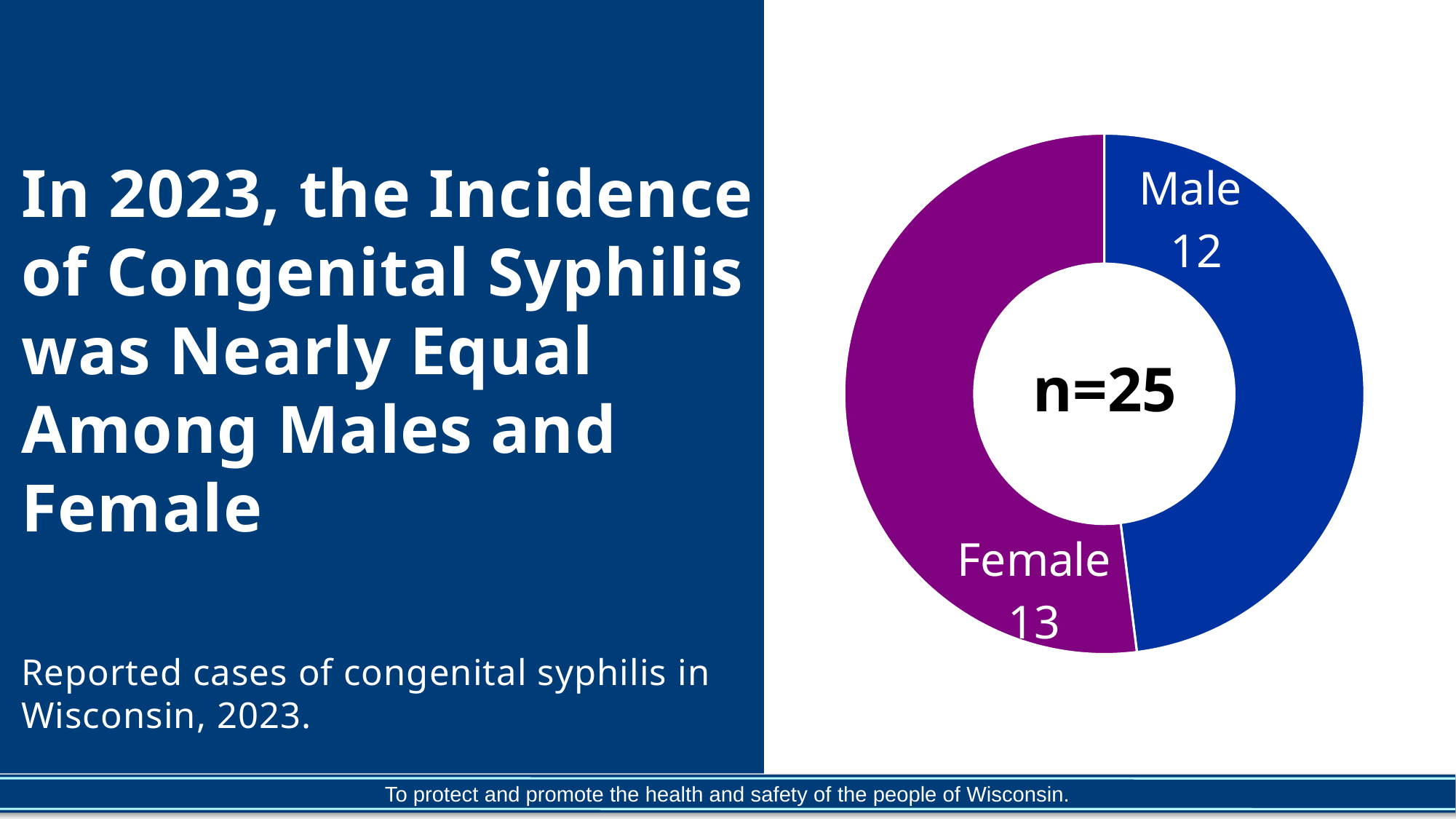
What is the number of reported congenital syphilis cases among females? 13 Which category has the smallest number of cases? Male Which category has the larger number of cases, Male or Female? Female What share of the total cases are female? 52% What is the difference between the number of female and male cases? 1 What is the number of reported congenital syphilis cases among males? 12 What kind of chart is shown on the slide? Donut (pie) chart What is the total number of cases shown in the centre of the donut chart? n=25 What share of the total cases are male? 48% Which category has the largest number of cases? Female How many categories does the chart show? 2 What is the total of the male and female cases combined? 25